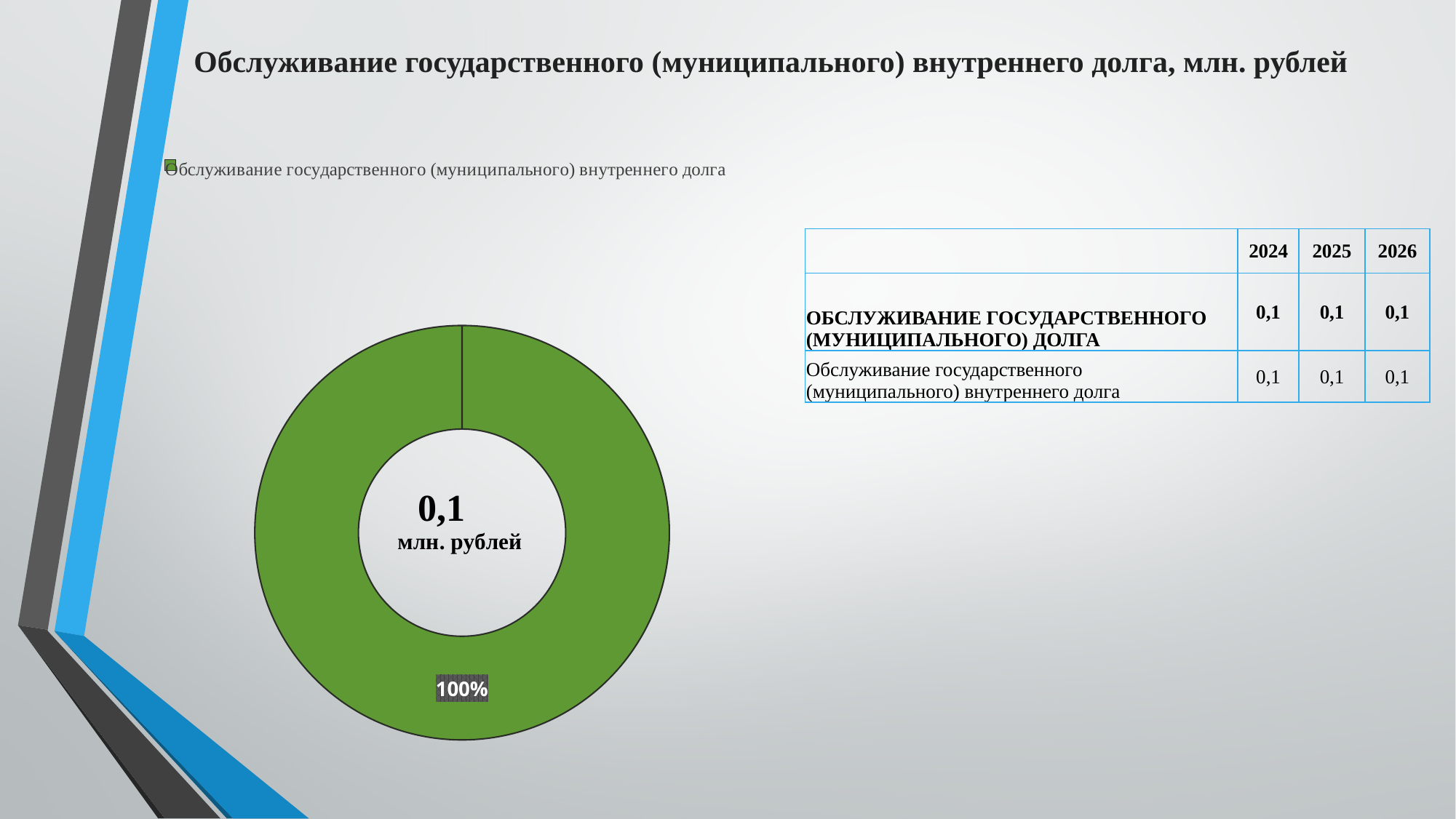
What colour is the slice of the doughnut chart? green How many slices does the doughnut chart have? 1 What unit is shown in the centre of the doughnut chart below the value 0,1? млн. рублей How many entries does the chart legend list? 1 What value is printed in the centre of the doughnut chart? 0,1 млн. рублей What kind of chart is shown on the slide? doughnut chart What is the legend entry of the doughnut chart? Обслуживание государственного (муниципального) внутреннего долга What is the percentage label shown on the green slice of the doughnut chart? 100% What share of the doughnut chart does the slice for "Обслуживание государственного (муниципального) внутреннего долга" take? 100%